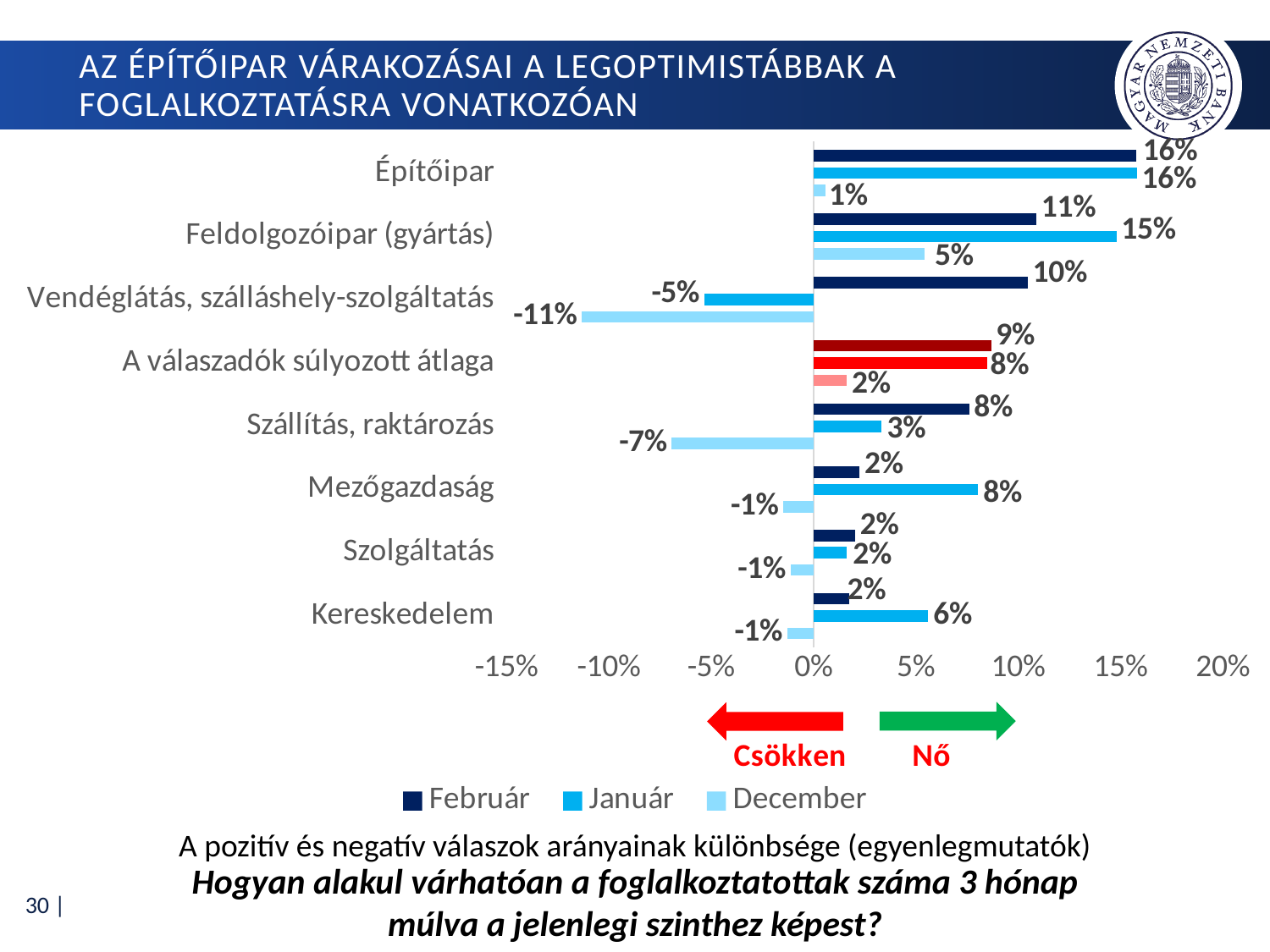
Which category has the highest Január value? Építőipar Which is larger for Mezőgazdaság: the Február value or the Január value? Január How many series does the legend list? 3 What is the December value for Vendéglátás, szálláshely-szolgáltatás? -11% How many categories are shown on the chart? 8 What is the Január value for Feldolgozóipar (gyártás)? 15% What is the Február value for A válaszadók súlyozott átlaga? 9% What kind of chart is shown on the slide? bar chart What is the December value for Szállítás, raktározás? -7% What is the Február value for Építőipar? 16% Which category has the lowest December value? Vendéglátás, szálláshely-szolgáltatás What is the difference between the Január and December values for Feldolgozóipar (gyártás)? 10%